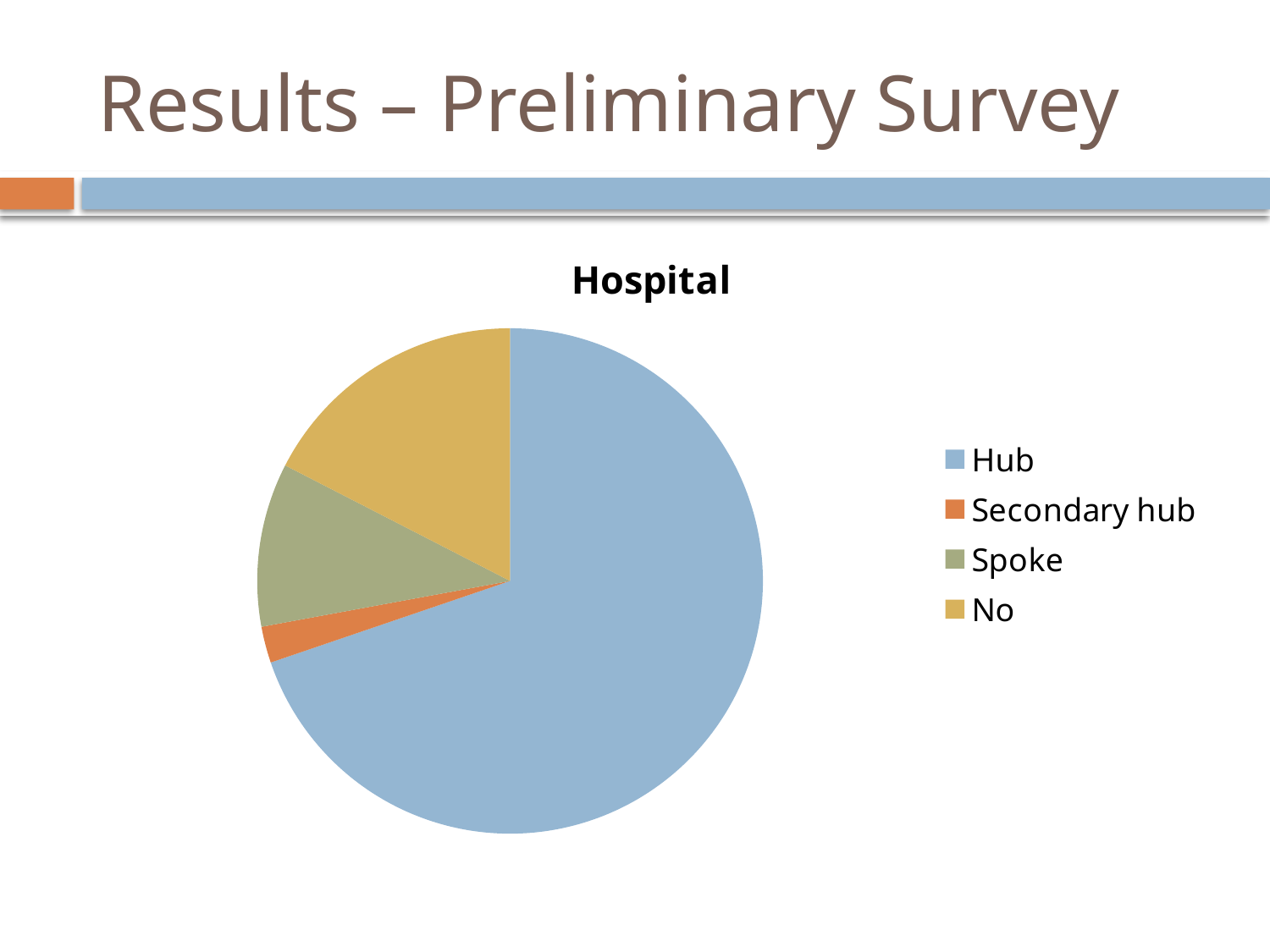
Which category has the smallest slice of the pie? Secondary hub What kind of chart is shown on the slide? pie chart Which category has the largest slice of the pie? Hub What is the title of the chart? Hospital Which category is shown in orange in the pie chart? Secondary hub Which slice is larger, Secondary hub or Spoke? Spoke Which slice is larger, Spoke or No? No How many slices does the pie chart have? 4 How many entries does the legend list? 4 Which slice is larger, Hub or No? Hub